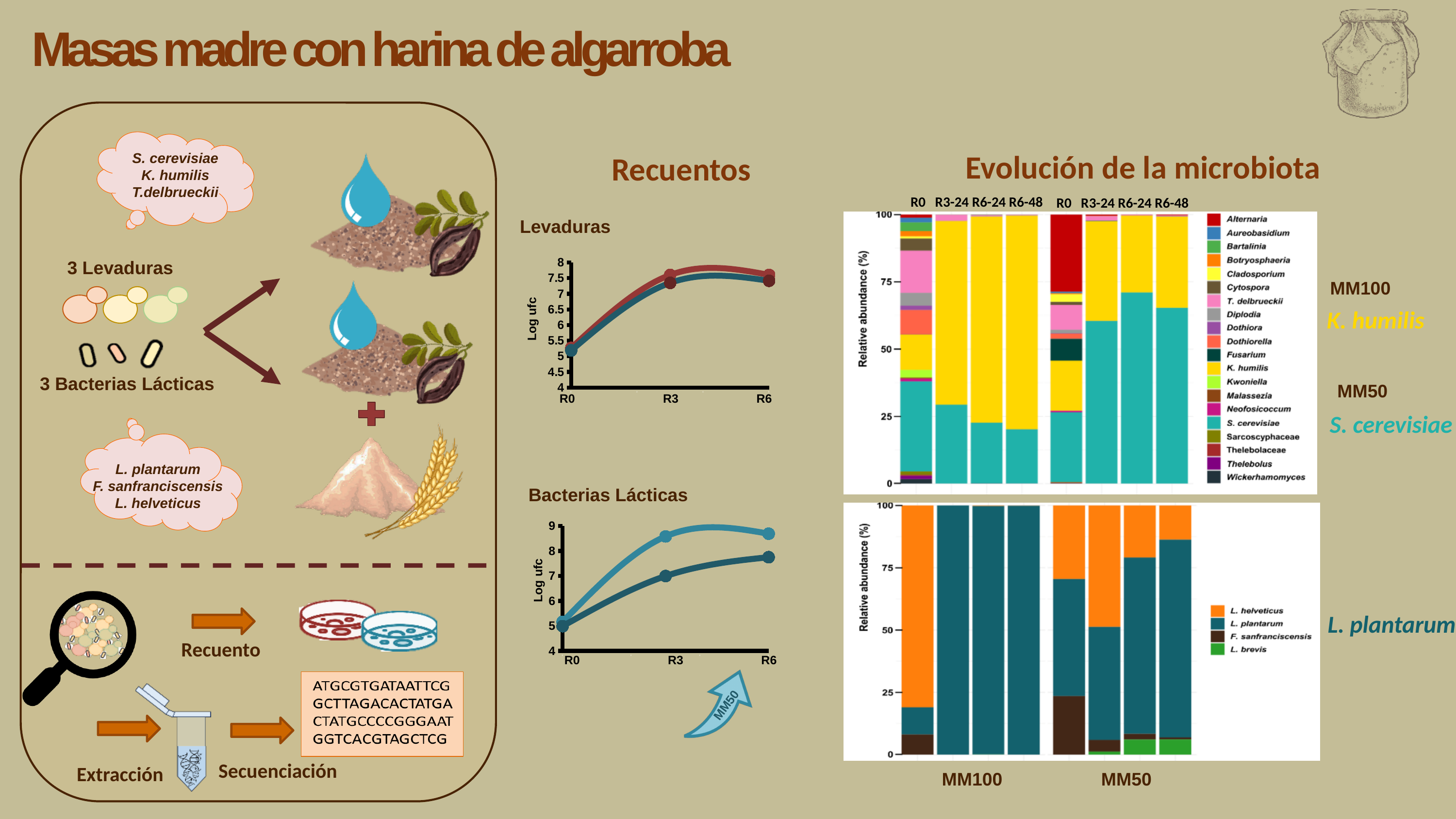
What is the highest value shown on the y axis of the 'Bacterias Lácticas' line chart? 9 What kind of charts are shown under 'Evolución de la microbiota'? stacked bar charts What kind of chart is the 'Levaduras' chart under 'Recuentos'? line chart In the lower stacked bar chart, which species makes up the entire MM100 R3-24 bar? L. plantarum How many species does the legend of the lower stacked bar chart (lactic acid bacteria) list? 4 In the 'Bacterias Lácticas' line chart, which line is higher at R3, the lighter blue or the darker blue? lighter blue In the 'Levaduras' line chart, do the values rise or fall from R0 to R3? rise How many stacked bars are there in the lower stacked bar chart (lactic acid bacteria)? 8 In the lower stacked bar chart, is the share of L. helveticus in the MM100 R0 bar greater or less than 75? greater In the 'Bacterias Lácticas' line chart, is the value of the lighter blue line at R3 greater or less than 8? greater How many time points are plotted on the x axis of the 'Levaduras' line chart? 3 In the 'Levaduras' line chart, are the values at R0 greater or less than 5.5? less